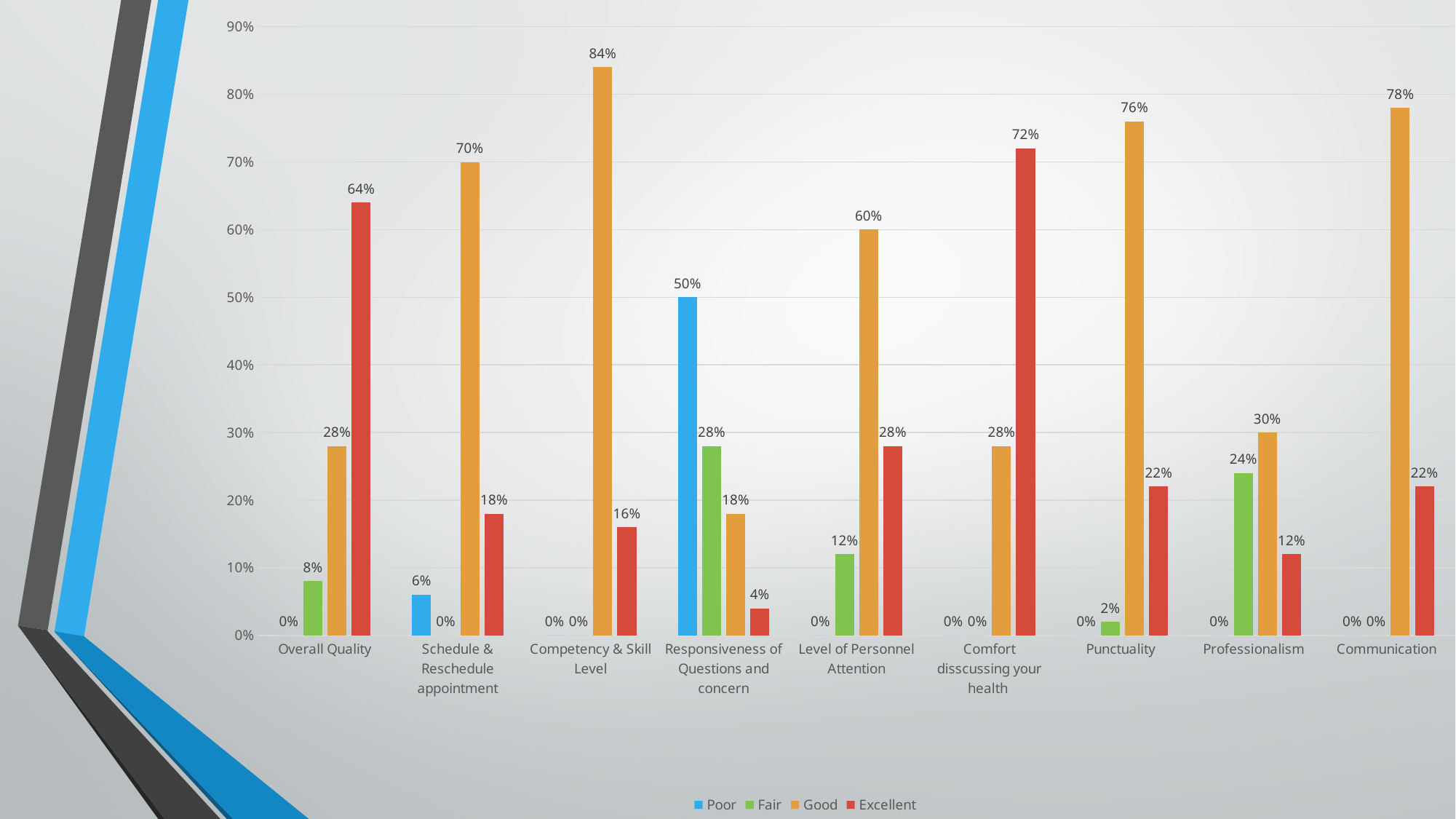
Which colour represents the Excellent series in the legend? Red What is the Excellent value for Overall Quality? 64% Which category has the highest Excellent value? Comfort disscussing your health Which is larger: the Excellent value for Schedule & Reschedule appointment or the Excellent value for Competency & Skill Level? Schedule & Reschedule appointment How many series does the legend list? 4 What is the Poor value for Responsiveness of Questions and concern? 50% What is the difference between the Good value for Punctuality and the Good value for Communication? 2% What is the Fair value for Professionalism? 24% What kind of chart is shown on the slide? Bar chart Which category has the highest Good value? Competency & Skill Level What is the Good value for Competency & Skill Level? 84% How many categories are shown on the x axis? 9